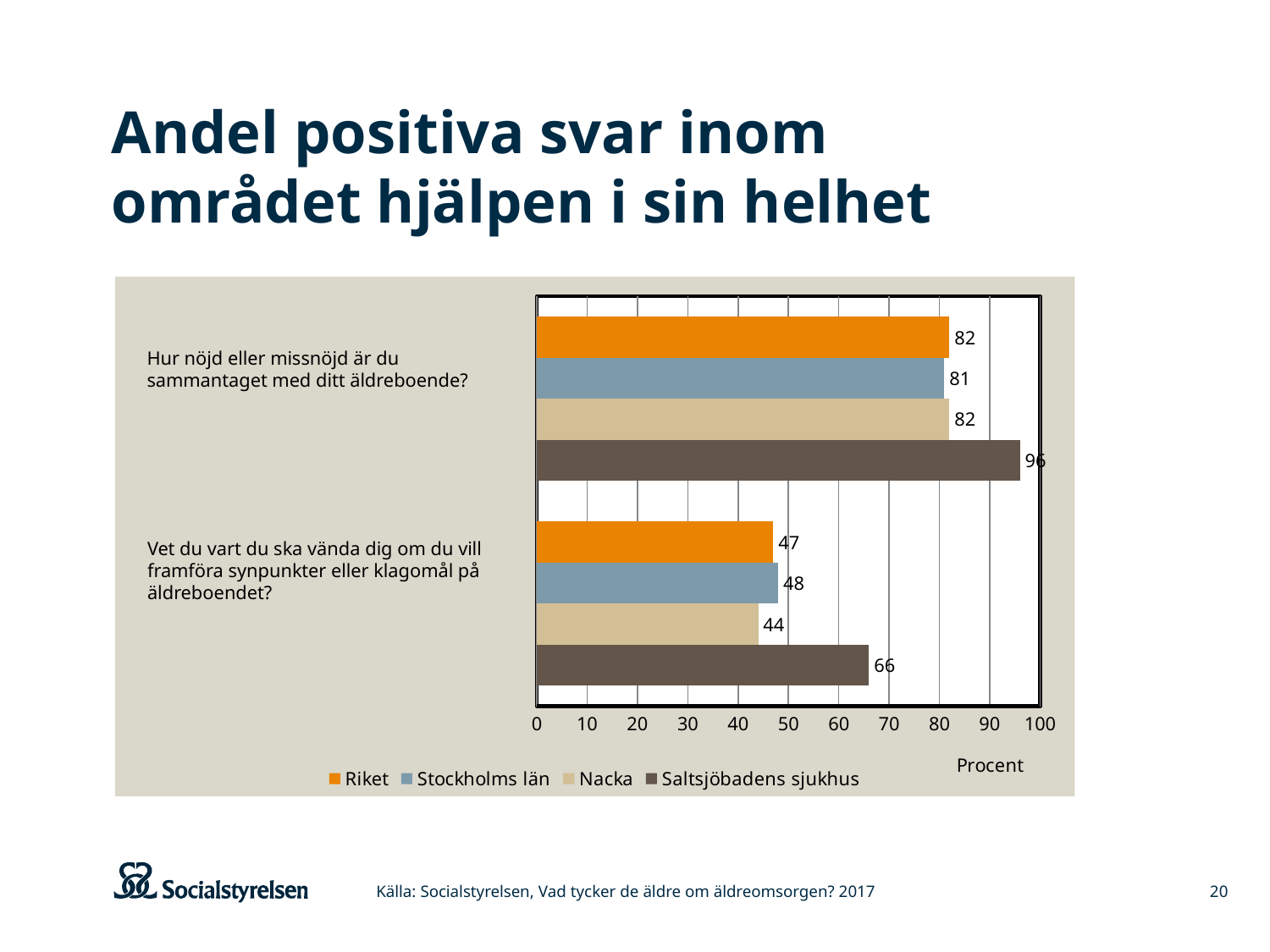
Which series has the lowest value on the question "Vet du vart du ska vända dig om du vill framföra synpunkter eller klagomål på äldreboendet?"? Nacka What kind of chart is shown on the slide? bar chart How many series does the legend list? 4 How many questions (categories) are shown on the chart? 2 Which is larger on the question "Vet du vart du ska vända dig om du vill framföra synpunkter eller klagomål på äldreboendet?": Saltsjöbadens sjukhus or Stockholms län? Saltsjöbadens sjukhus What is the value for Saltsjöbadens sjukhus on the question "Hur nöjd eller missnöjd är du sammantaget med ditt äldreboende?"? 96 What is the value for Nacka on the question "Vet du vart du ska vända dig om du vill framföra synpunkter eller klagomål på äldreboendet?"? 44 What is the value for Riket on the question "Vet du vart du ska vända dig om du vill framföra synpunkter eller klagomål på äldreboendet?"? 47 What is the value for Stockholms län on the question "Hur nöjd eller missnöjd är du sammantaget med ditt äldreboende?"? 81 What unit is shown on the x axis of the chart? Procent Which series has the highest value on the question "Vet du vart du ska vända dig om du vill framföra synpunkter eller klagomål på äldreboendet?"? Saltsjöbadens sjukhus What is the difference between Saltsjöbadens sjukhus and Riket on the question "Hur nöjd eller missnöjd är du sammantaget med ditt äldreboende?"? 14